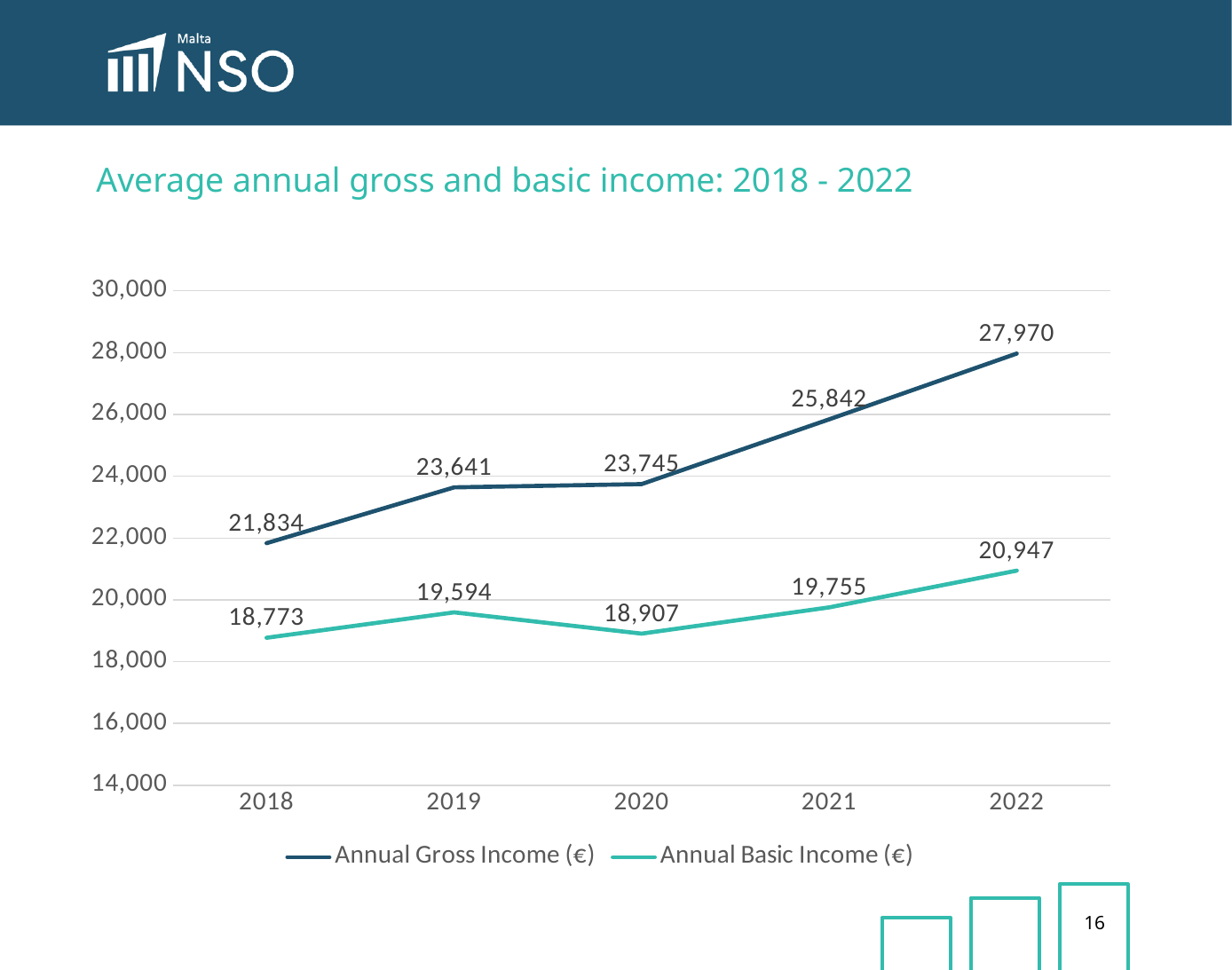
What is the Annual Gross Income (€) value for 2018? 21,834 Which is larger: Annual Basic Income (€) in 2019 or in 2020? 2019 Is the Annual Gross Income (€) value for 2021 greater or less than 24,000? greater What is the Annual Basic Income (€) value for 2020? 18,907 How many years are shown on the x axis? 5 What kind of chart is shown on the slide? line chart How many series does the legend list? 2 What is the difference between Annual Gross Income (€) and Annual Basic Income (€) in 2022? 7,023 In which year is Annual Basic Income (€) lowest? 2018 In which year is Annual Gross Income (€) highest? 2022 By how much did Annual Gross Income (€) increase from 2021 to 2022? 2,128 What is the Annual Gross Income (€) value for 2022? 27,970